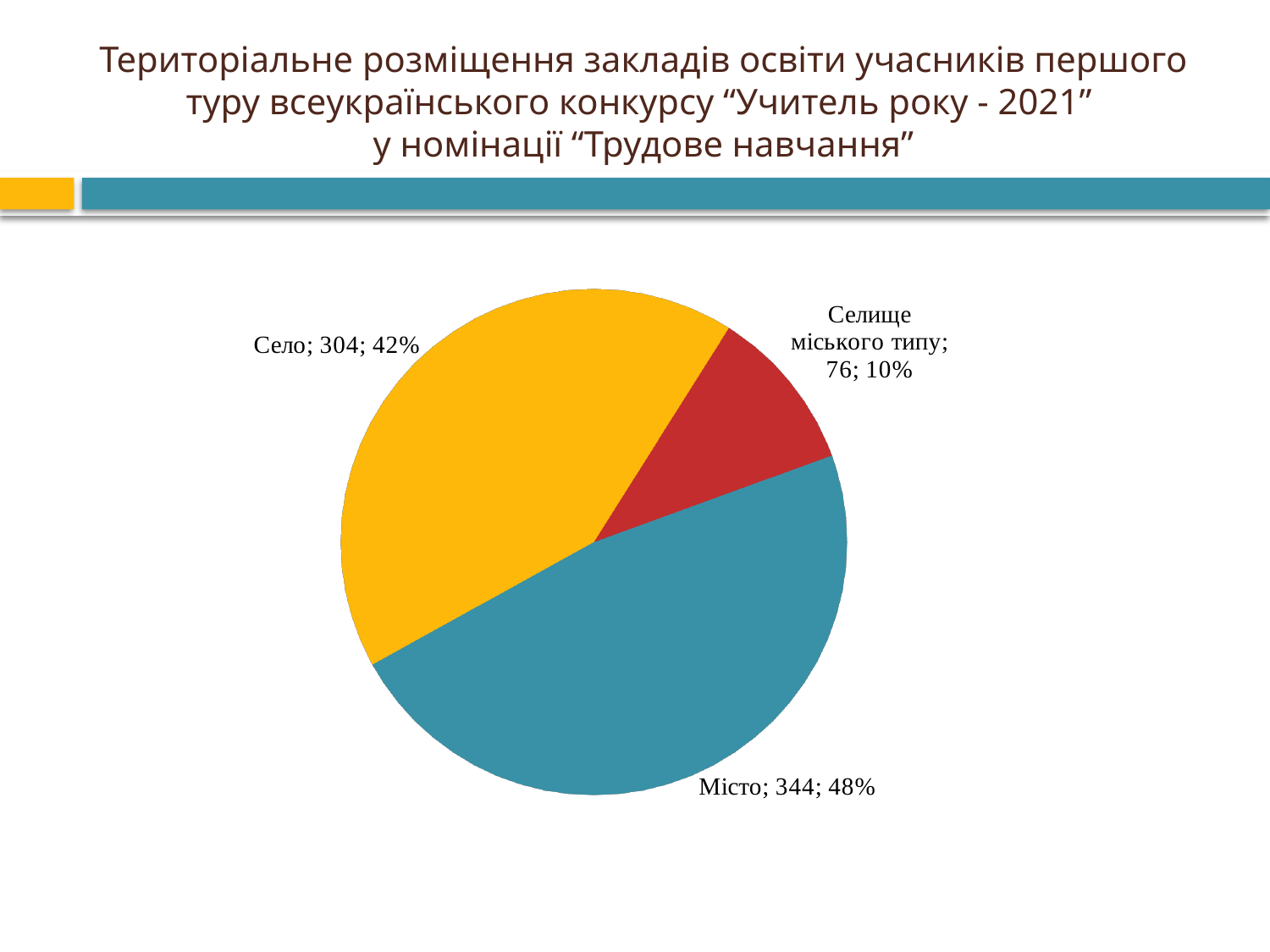
Which category has the smallest slice? Селище міського типу What share of the pie does Селище міського типу represent? 10% What is the value for Село? 304 What share of the pie does Село represent? 42% What is the difference between the values for Місто and Село? 40 Which category has the largest slice? Місто What colour is the slice for Місто? teal blue How many slices does the pie chart have? 3 Which is larger, the value for Село or the value for Селище міського типу? Село What is the value for Селище міського типу? 76 What kind of chart is shown on the slide? pie chart What is the value for Місто? 344